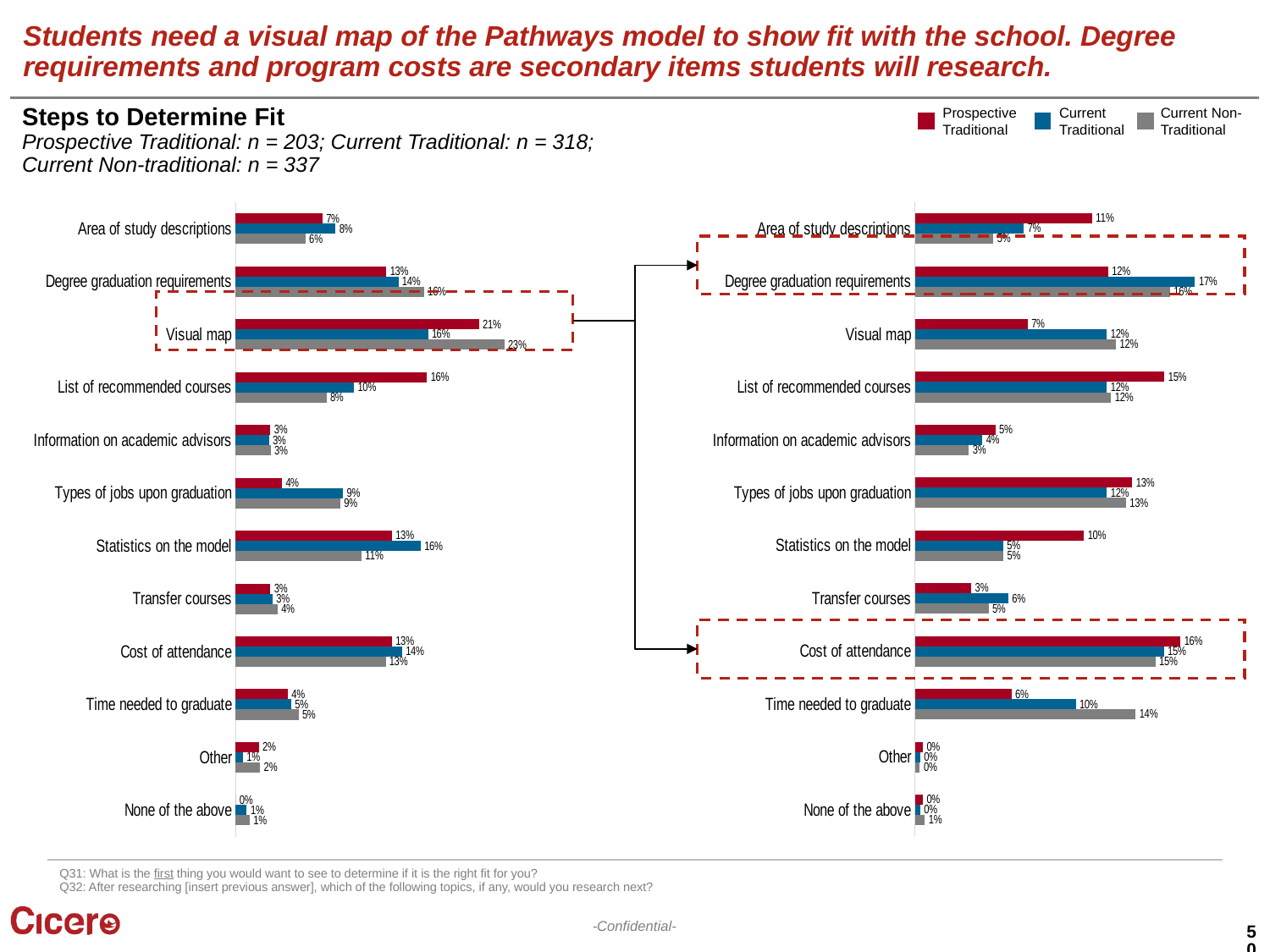
On the right chart, what is the Current Traditional value for Degree graduation requirements? 17% What type of chart is the right chart? Bar chart On the right chart, which category has the highest Prospective Traditional value? Cost of attendance On the right chart, what is the difference between the Prospective Traditional and Current Traditional values for Statistics on the model? 5% On the left chart, what is the Prospective Traditional value for List of recommended courses? 16% How many categories are shown on the left chart? 12 On the left chart, which category has the highest Prospective Traditional value? Visual map On the left chart, what is the difference between the Prospective Traditional and Current Traditional values for Types of jobs upon graduation? 5% On the right chart, what is the Current Non-Traditional value for Time needed to graduate? 14% How many series does the legend list? 3 On the right chart, which is larger for Visual map: the Prospective Traditional value or the Current Traditional value? Current Traditional On the left chart, what is the Current Non-Traditional value for Visual map? 23%